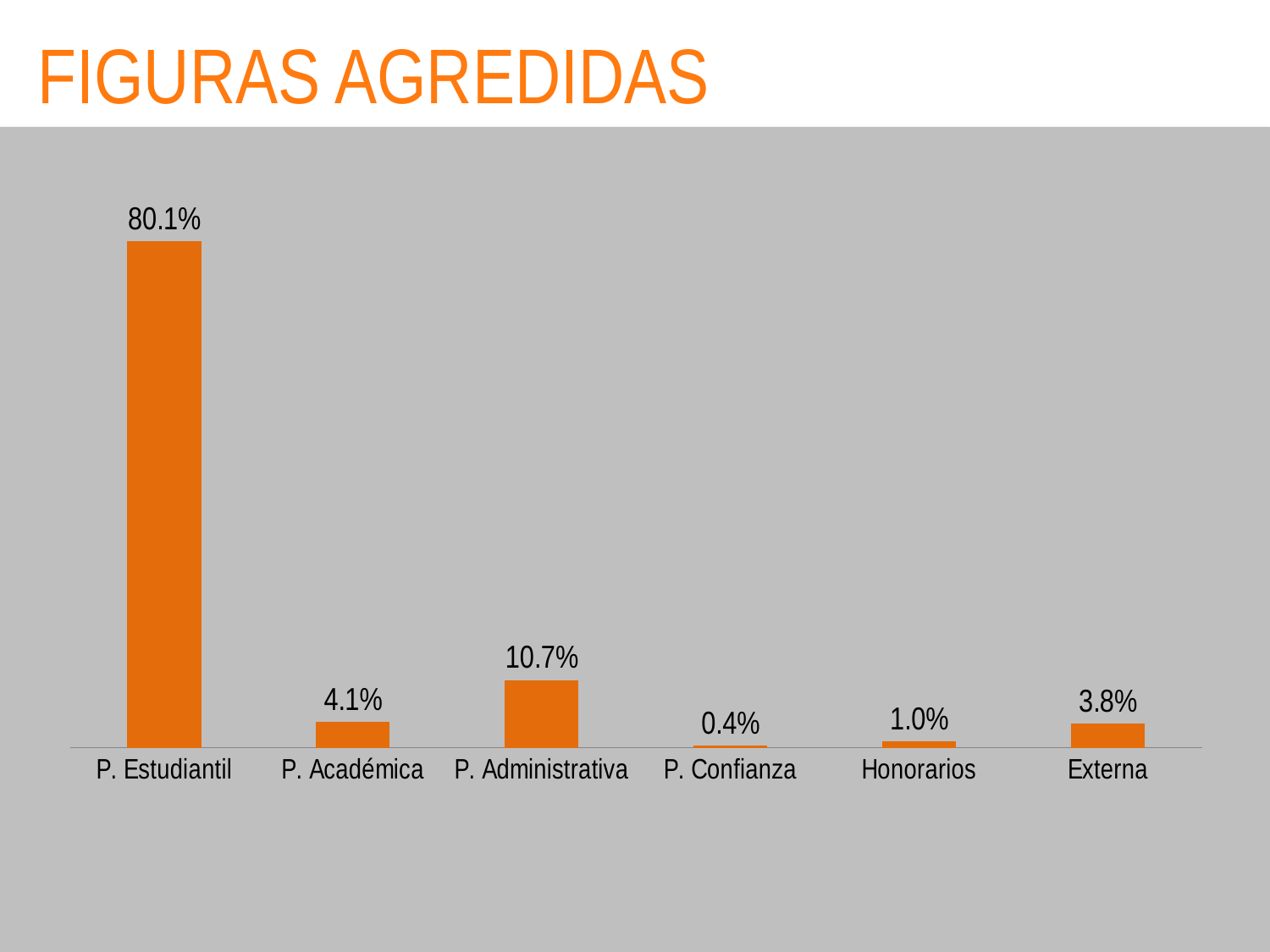
What is the value for Externa? 3.8% What is the difference between the values for P. Académica and Externa? 0.3% What is the title of the slide? FIGURAS AGREDIDAS What is the value for P. Administrativa? 10.7% What is the value for P. Estudiantil? 80.1% Which category has the lowest value? P. Confianza How many categories are shown in the chart? 6 What is the difference between the values for P. Estudiantil and P. Administrativa? 69.4% What kind of chart is shown on the slide? Bar chart Which category has the highest value? P. Estudiantil What is the value for Honorarios? 1.0% Which is larger, the value for P. Académica or the value for Honorarios? P. Académica